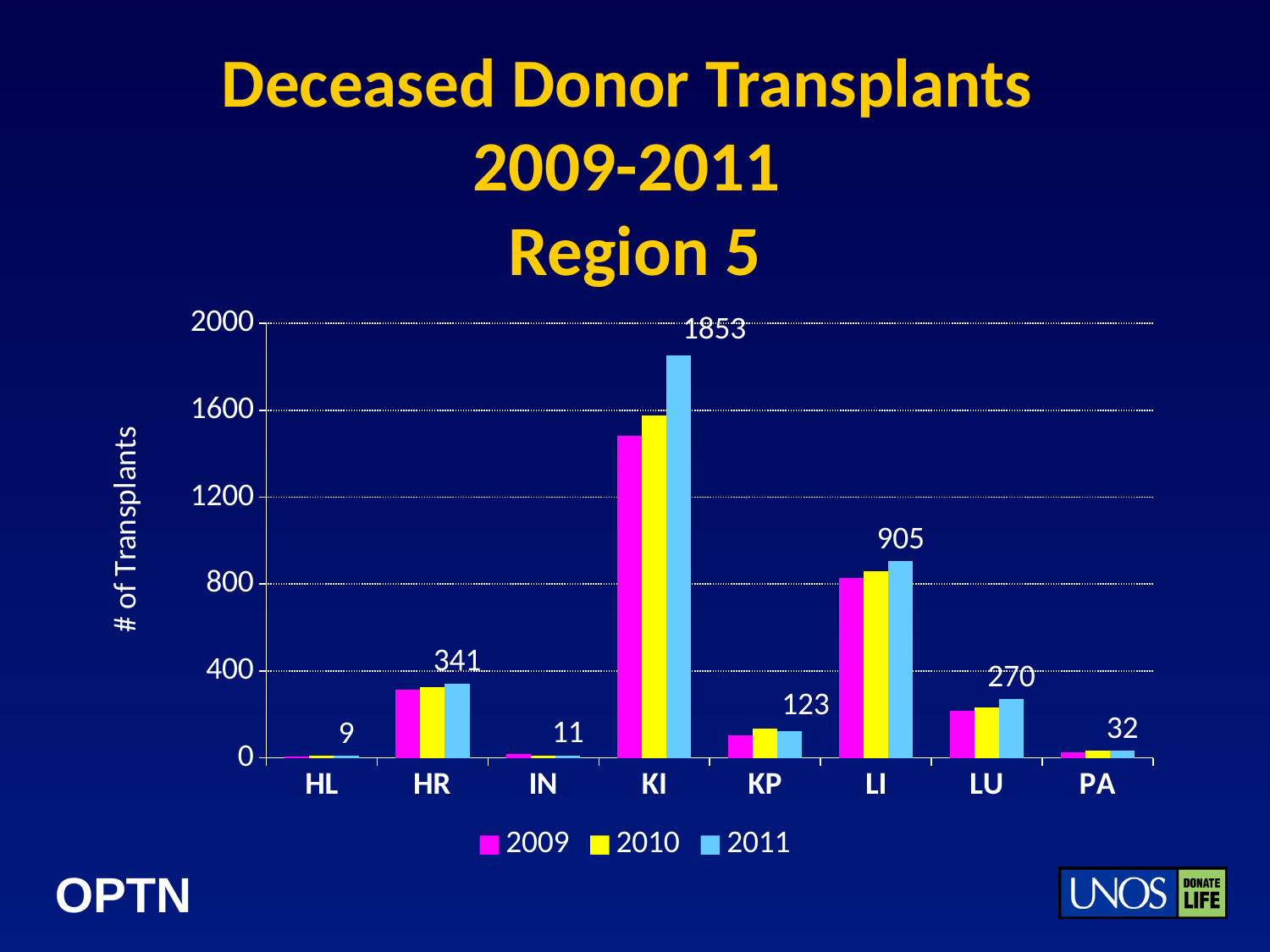
What is the difference between the 2011 values for KI and LI? 948 What type of chart is shown on the slide? Bar chart What is the 2011 value for LI? 905 What is the 2011 value for KI? 1853 Which organ category has the highest number of transplants in 2011? KI How many series does the legend list? 3 How many organ categories are shown on the x axis? 8 What is the 2011 value for PA? 32 Is the 2009 value for KI greater or less than 1200? greater What is the 2011 value for HR? 341 Which organ category has the lowest number of transplants in 2011? HL Which is larger in 2011, LU or KP? LU